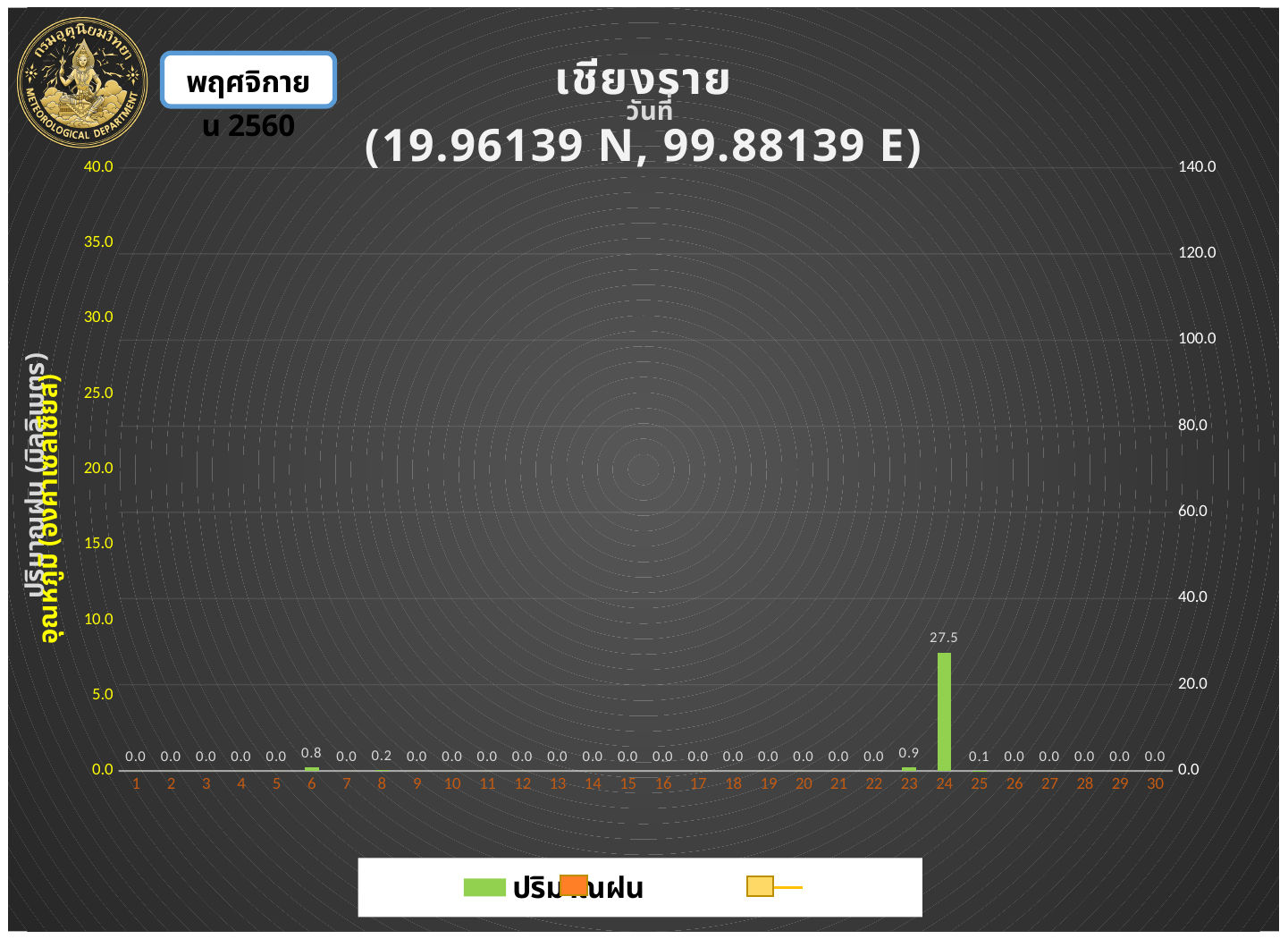
What is the rainfall value shown for day 24? 27.5 Which day has the highest rainfall value? 24 Which has a larger rainfall value, day 6 or day 8? Day 6 What is the rainfall value shown for day 25? 0.1 How many days are shown on the x axis? 30 What is the rainfall value shown for day 23? 0.9 What coordinates are given in the chart title? 19.96139 N, 99.88139 E What is the rainfall value shown for day 6? 0.8 What kind of chart is shown on the slide? Bar chart Is the rainfall value for day 24 greater or less than 20.0 on the right axis? greater What is the rainfall value shown for day 8? 0.2 What is the difference between the rainfall values for day 24 and day 23? 26.6